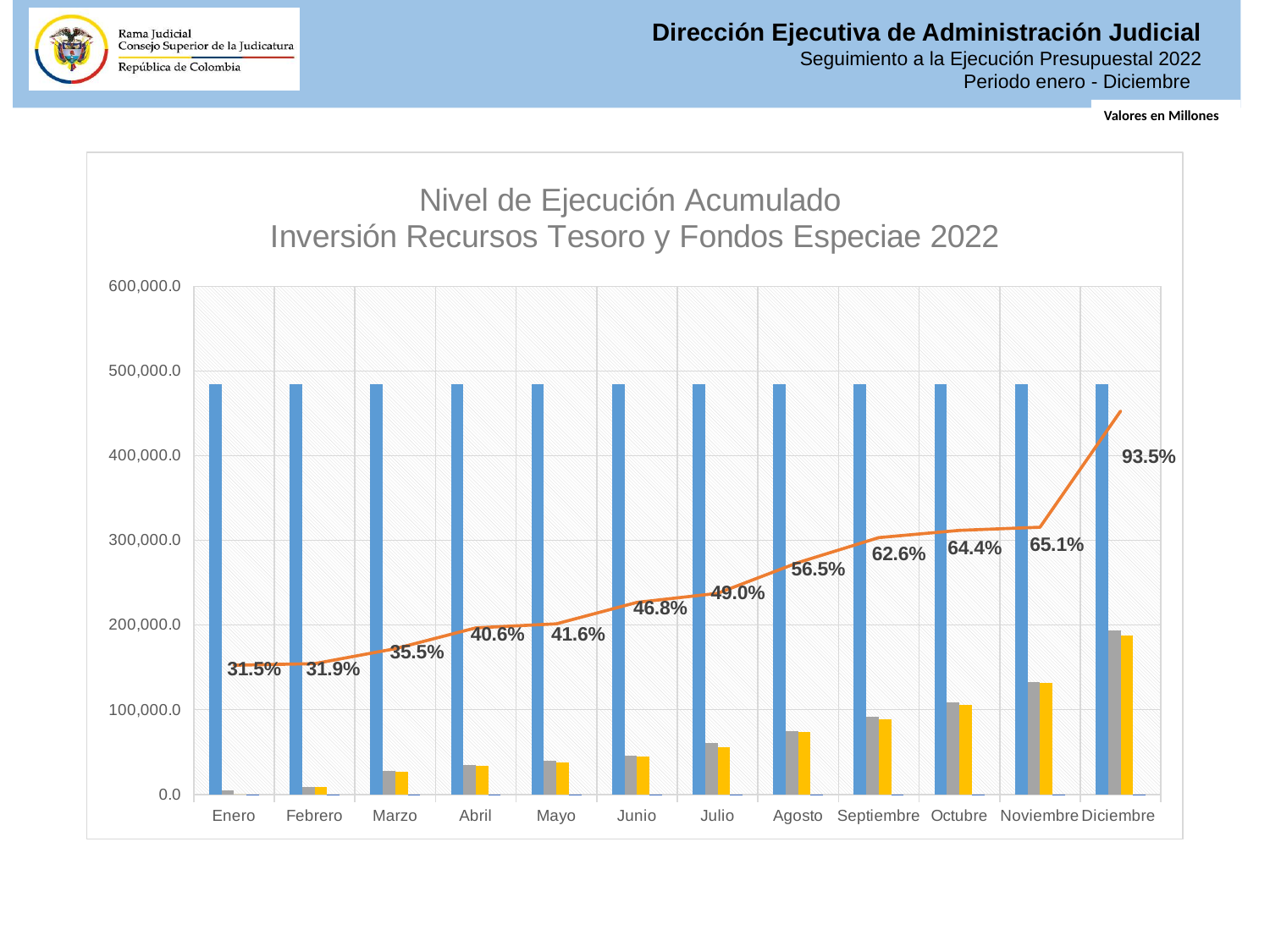
What is the percentage label shown for Octubre on the line? 64.4% What is the percentage label shown for Diciembre on the line? 93.5% Which month has the lowest percentage label on the line? Enero What is the difference between the percentage labels for Diciembre and Noviembre? 28.4% What is the percentage label shown for Agosto on the line? 56.5% Is the value of the blue bar for Enero greater or less than 500,000.0? less Do the percentage labels on the line rise or fall from Enero to Diciembre? rise What is the title of the chart? Nivel de Ejecución Acumulado Inversión Recursos Tesoro y Fondos Especiae 2022 What is the percentage label shown for Enero on the line? 31.5% How many months are shown on the x axis? 12 Which has a higher percentage label, Junio or Mayo? Junio Which month has the highest percentage label on the line? Diciembre